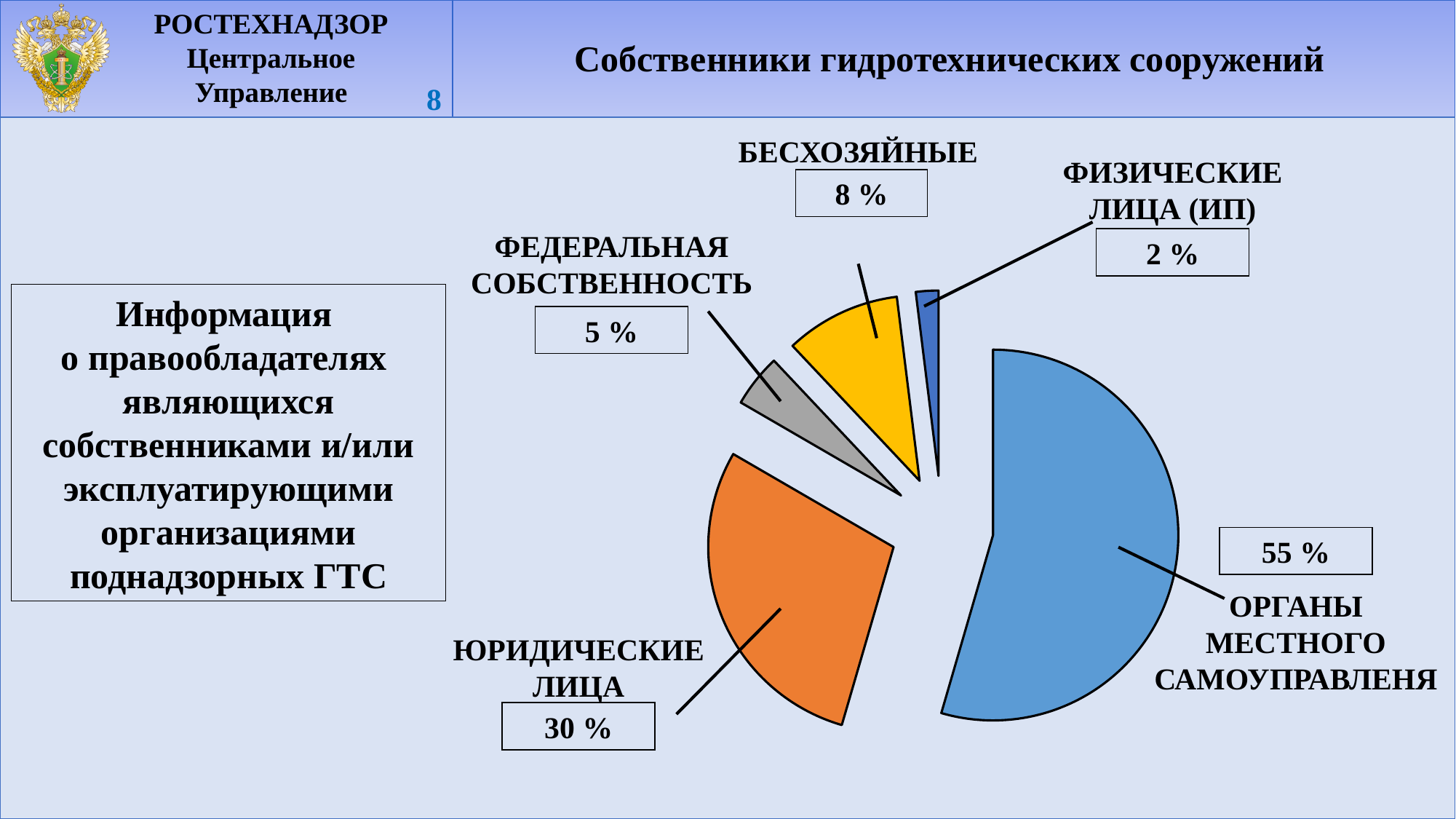
What share of the pie chart is labelled ФЕДЕРАЛЬНАЯ СОБСТВЕННОСТЬ? 5 % What is the title of the chart on the slide? Собственники гидротехнических сооружений What share of the pie chart is labelled ЮРИДИЧЕСКИЕ ЛИЦА? 30 % Which category has the smallest slice of the pie chart? ФИЗИЧЕСКИЕ ЛИЦА (ИП) What is the difference in percentage points between ОРГАНЫ МЕСТНОГО САМОУПРАВЛЕНЯ and ЮРИДИЧЕСКИЕ ЛИЦА? 25 % Which category has the largest slice of the pie chart? ОРГАНЫ МЕСТНОГО САМОУПРАВЛЕНЯ What share of the pie chart is labelled ОРГАНЫ МЕСТНОГО САМОУПРАВЛЕНЯ? 55 % What share of the pie chart is labelled БЕСХОЗЯЙНЫЕ? 8 % Which is larger, the share for БЕСХОЗЯЙНЫЕ or the share for ФЕДЕРАЛЬНАЯ СОБСТВЕННОСТЬ? БЕСХОЗЯЙНЫЕ How many slices does the pie chart have? 5 What kind of chart is shown on the slide? pie chart What share of the pie chart is labelled ФИЗИЧЕСКИЕ ЛИЦА (ИП)? 2 %